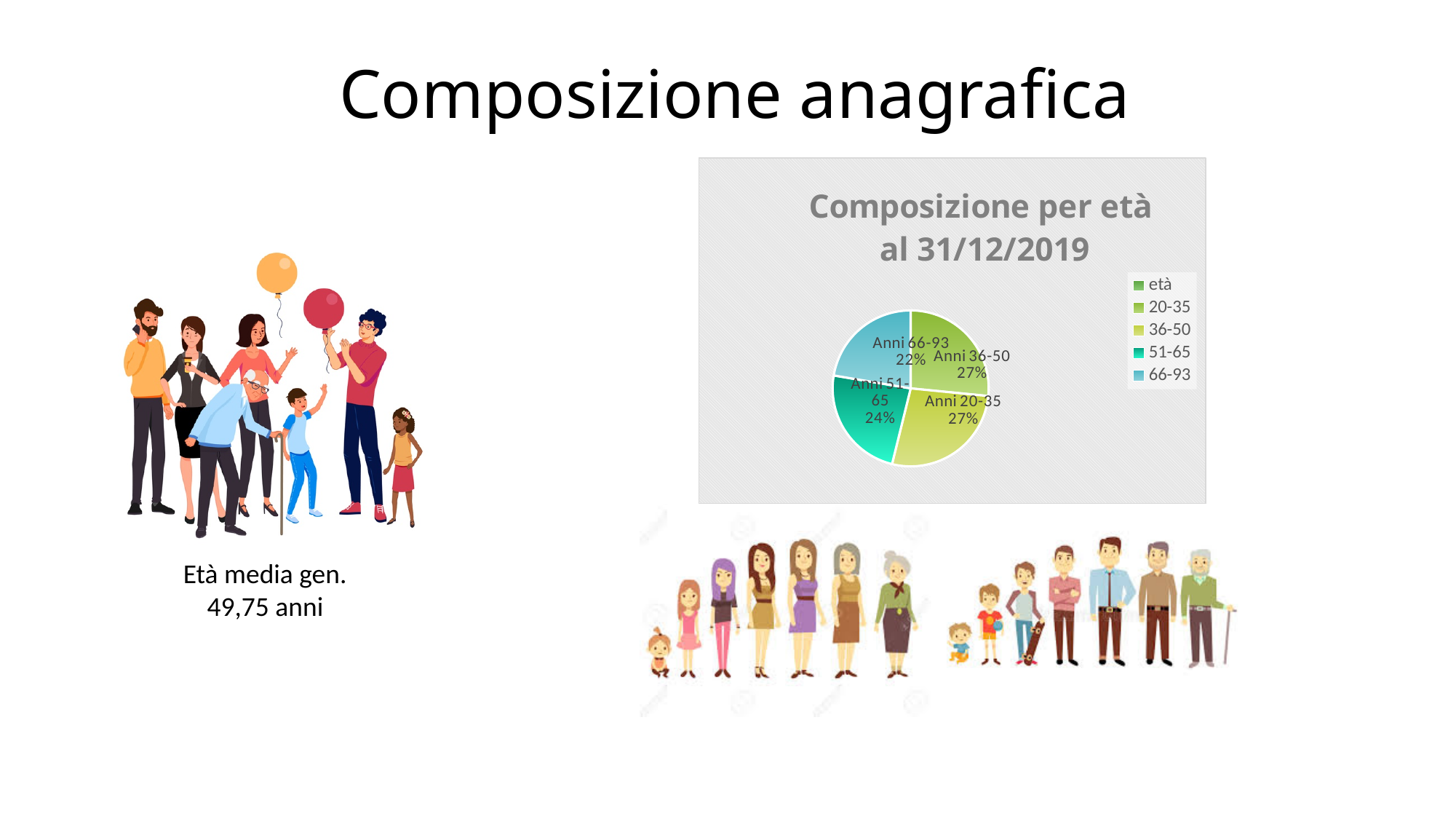
What share of the pie does the Anni 36-50 slice represent? 27% What kind of chart is shown on the slide? pie chart What share of the pie does the Anni 51-65 slice represent? 24% How many slices are labelled in the pie chart? 4 Which age group has the smallest slice of the pie? Anni 66-93 Which age group is shown in the light blue slice of the pie? 66-93 What share of the pie does the Anni 66-93 slice represent? 22% How many entries does the chart legend list? 5 What is the difference in percentage points between the Anni 36-50 slice and the Anni 66-93 slice? 5 Which slice is larger, Anni 51-65 or Anni 66-93? Anni 51-65 What is the title of the chart? Composizione per età al 31/12/2019